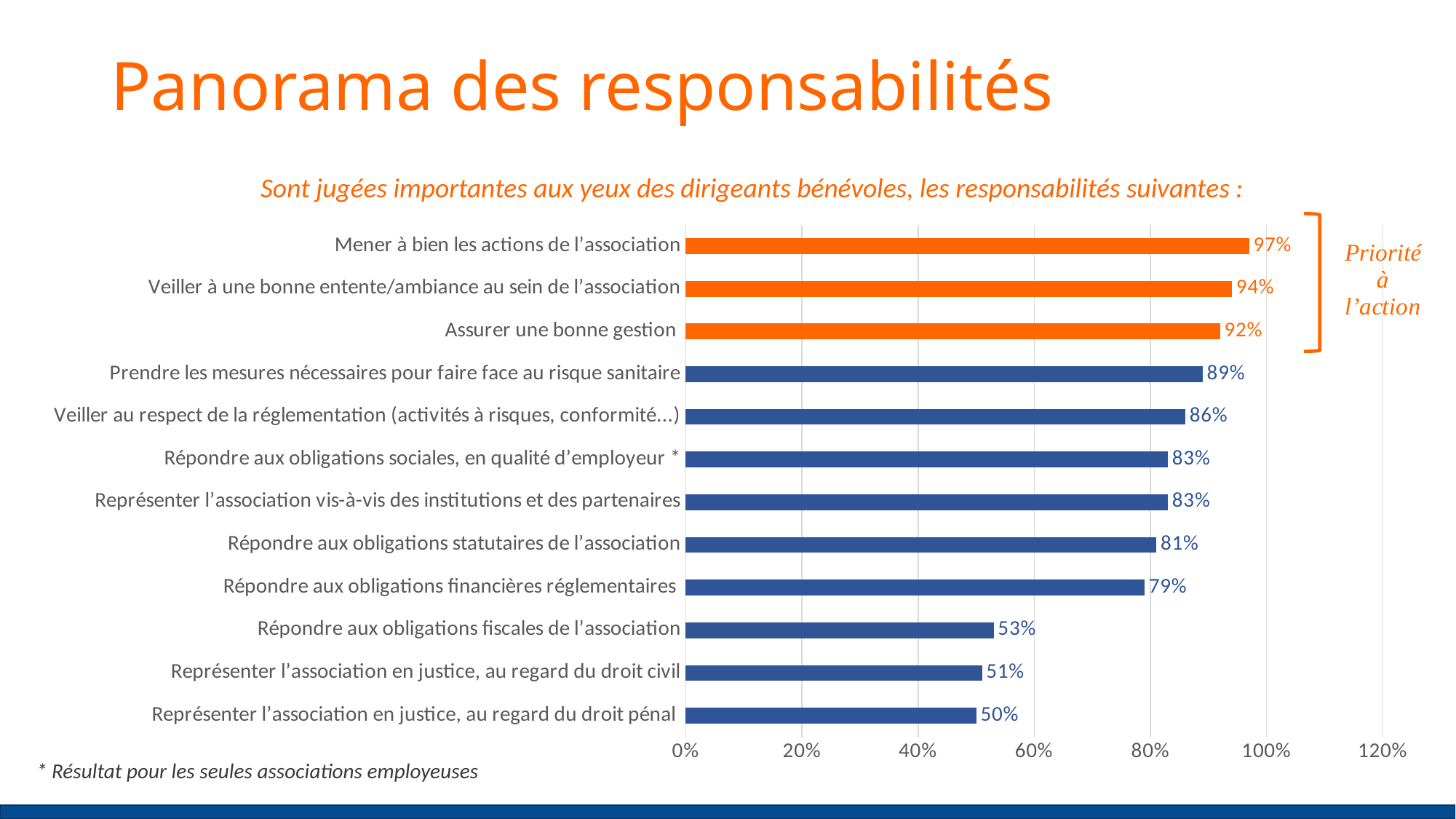
How many bars are coloured orange? 3 What kind of chart is shown on the slide? bar chart What is the value for "Répondre aux obligations fiscales de l'association"? 53% Is the value for "Répondre aux obligations fiscales de l'association" greater or less than 60%? less What is the difference between "Prendre les mesures nécessaires pour faire face au risque sanitaire" and "Répondre aux obligations financières réglementaires"? 10% What is the value for "Assurer une bonne gestion"? 92% What is the value for "Mener à bien les actions de l'association"? 97% Which category has the highest value? Mener à bien les actions de l'association Which is larger: the value for "Veiller au respect de la réglementation (activités à risques, conformité…)" or the value for "Répondre aux obligations statutaires de l'association"? Veiller au respect de la réglementation (activités à risques, conformité…) Which category has the lowest value? Représenter l'association en justice, au regard du droit pénal What is the difference between "Mener à bien les actions de l'association" and "Représenter l'association en justice, au regard du droit pénal"? 47% How many categories are shown in the chart? 12